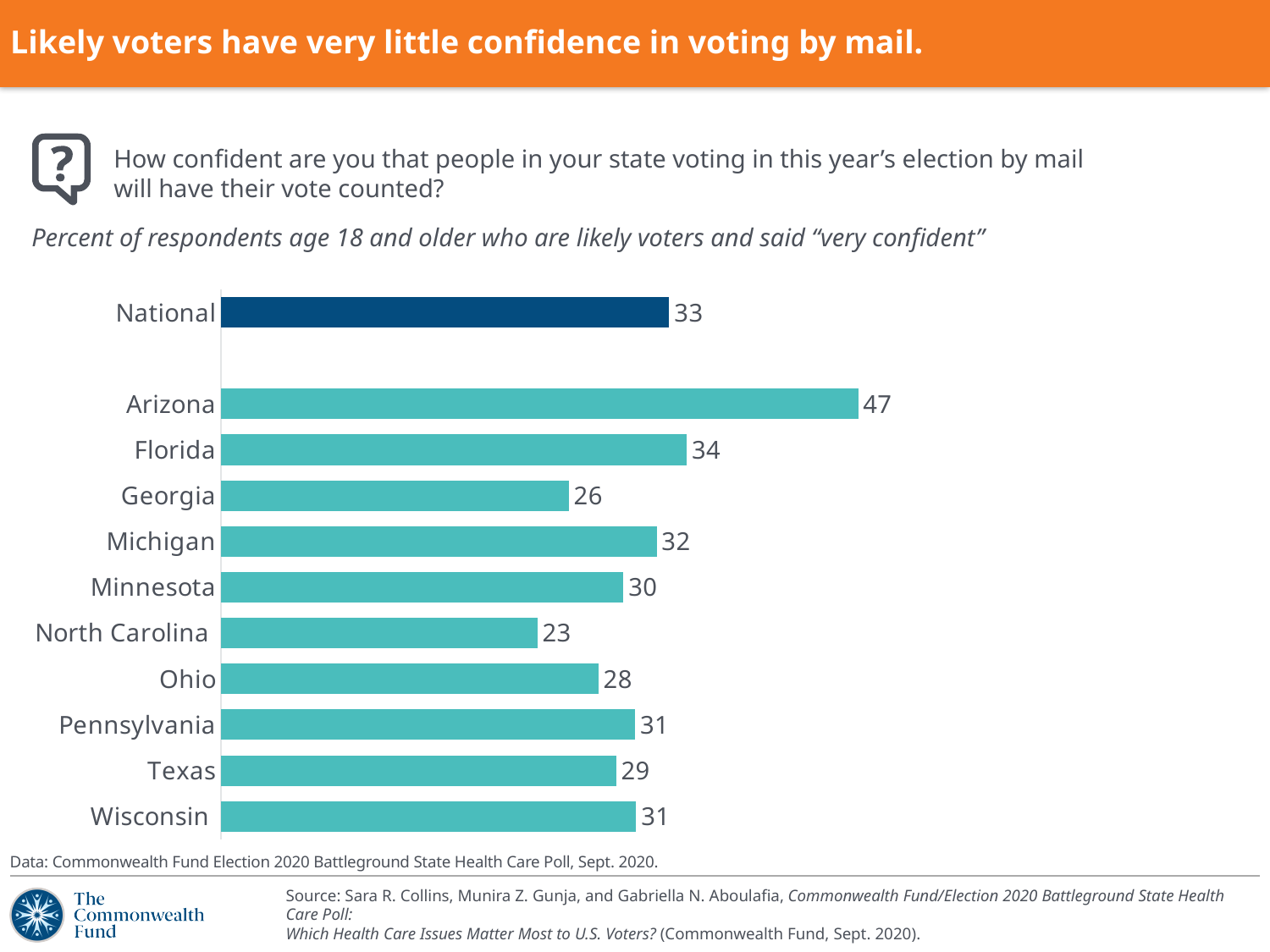
How many bars are shown in the chart? 11 Which bar is shown in a darker blue colour than the others? National Which is larger, the value for Ohio or the value for Texas? Texas What is the value for National? 33 What is the value for North Carolina? 23 What is the difference between the values for Arizona and Florida? 13 Which state has the lowest value? North Carolina Which is larger, the value for Michigan or the value for Minnesota? Michigan Which state has the highest value? Arizona What is the value for Arizona? 47 What is the difference between the values for Georgia and North Carolina? 3 What kind of chart is shown on the slide? Bar chart